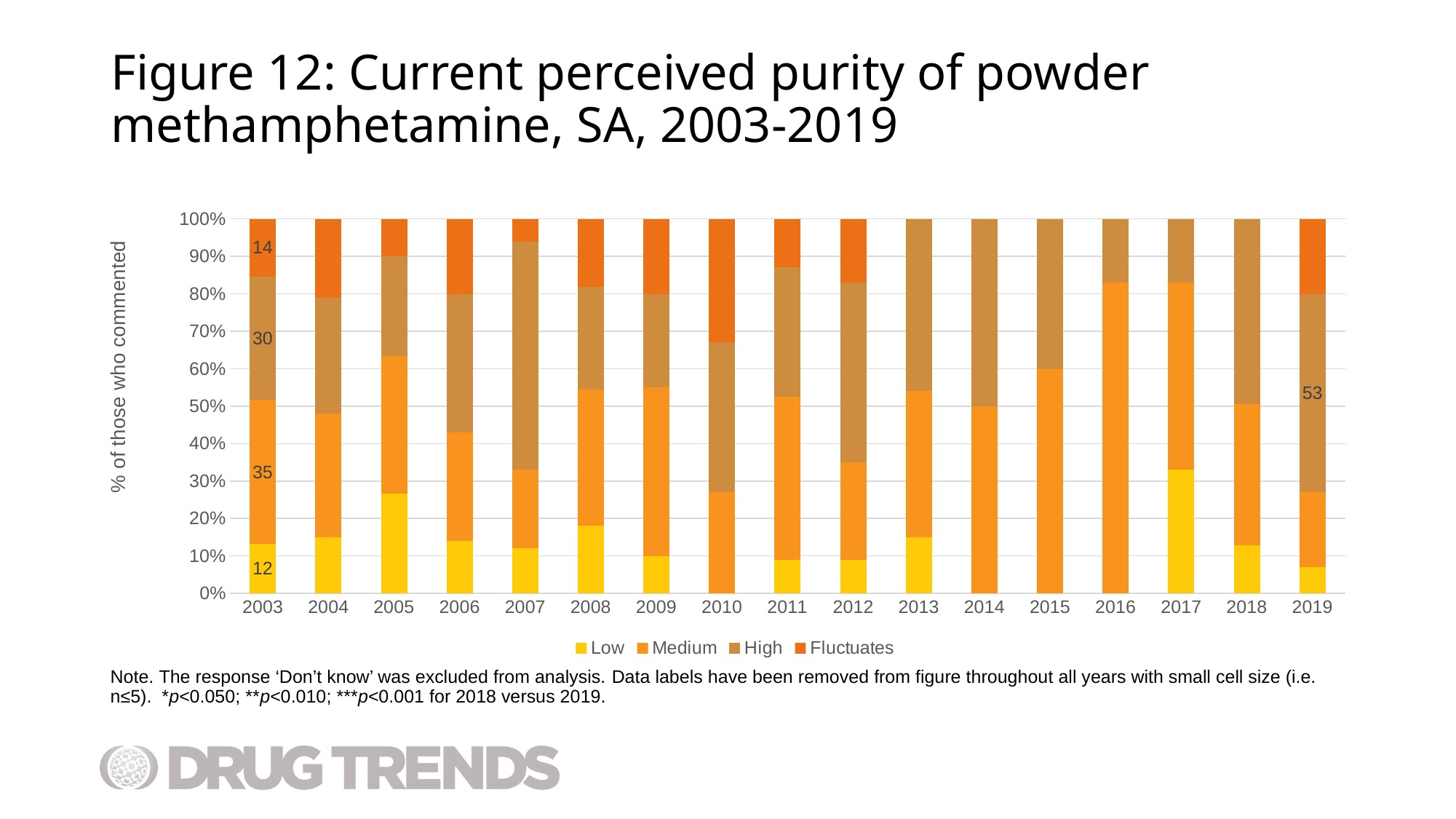
What is the value for High in 2019? 53 How many series does the legend list? 4 What is the value for Low in 2003? 12 What kind of chart is shown? Stacked bar chart What is the value for Medium in 2003? 35 In 2003, which is larger, Medium or High? Medium Is the Low share in 2017 greater or less than 20%? greater What is the value for Fluctuates in 2003? 14 Which year has the largest Low share? 2017 What is the difference between the Medium and High values in 2003? 5 How many years are shown on the x axis? 17 Which year has the largest Fluctuates share? 2010